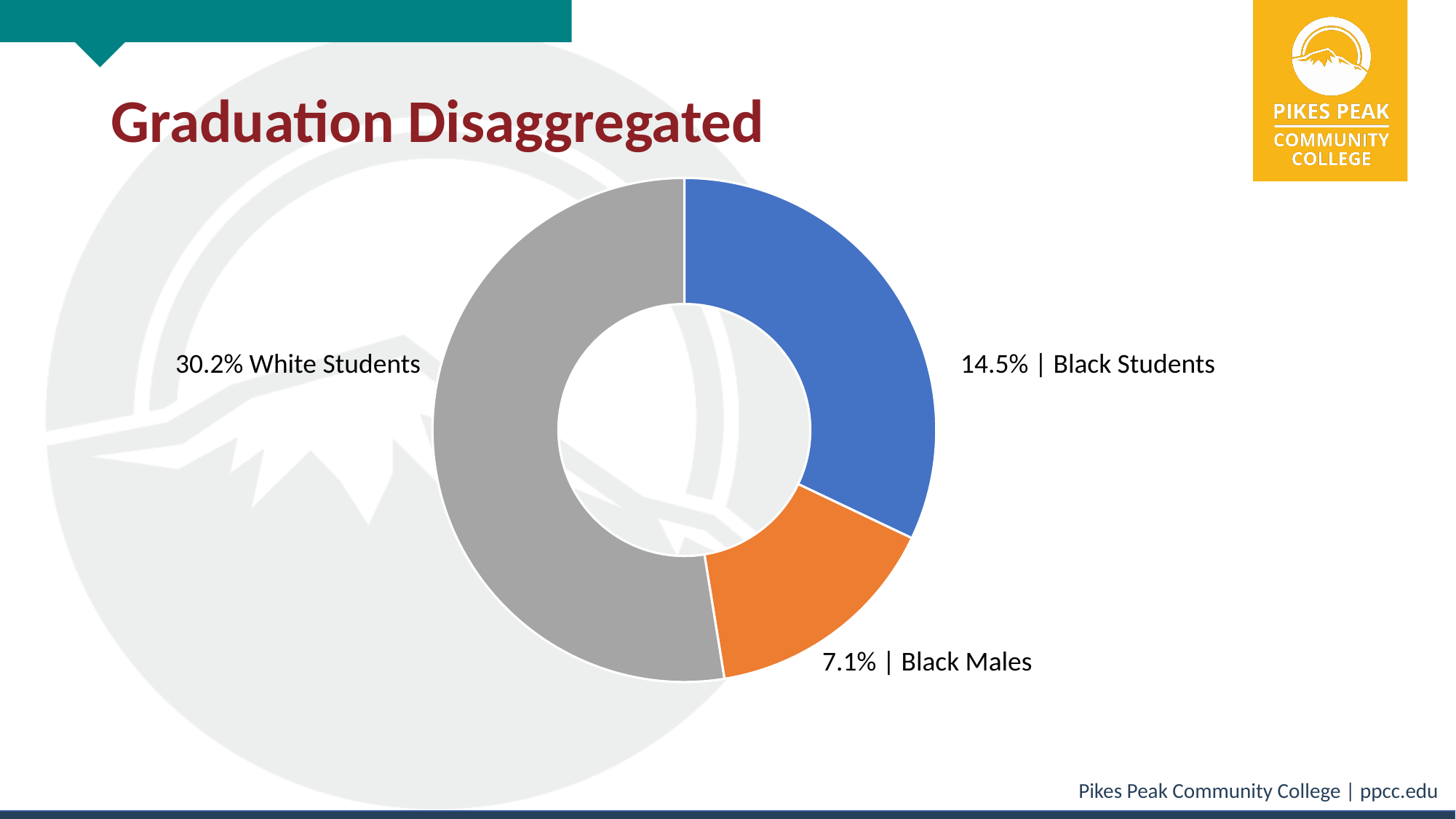
What colour is the segment for Black Males? orange Which group has the highest graduation rate on the chart? White Students Which group has the lowest graduation rate on the chart? Black Males What is the difference between the graduation rates for Black Students and Black Males? 7.4% Which is larger, the graduation rate for Black Students or for Black Males? Black Students What is the title of the slide containing the chart? Graduation Disaggregated What is the difference between the graduation rates for White Students and Black Students? 15.7% What is the graduation rate shown for White Students? 30.2% What is the graduation rate shown for Black Males? 7.1% What kind of chart is shown on the slide? doughnut chart How many groups are shown on the chart? 3 What is the graduation rate shown for Black Students? 14.5%